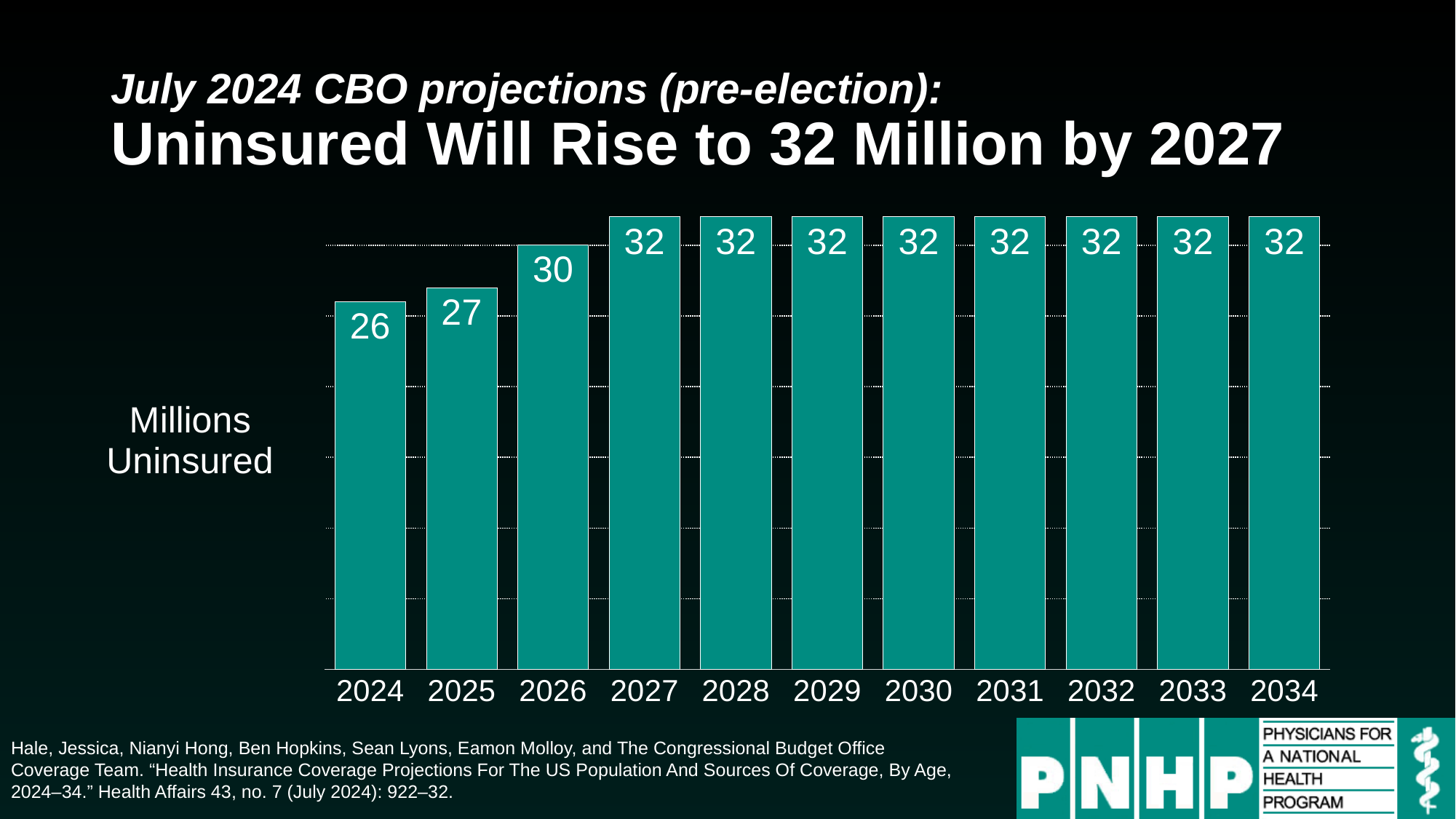
What is the label on the vertical axis? Millions Uninsured What kind of chart is this? bar chart Which is larger, the value for 2025 or the value for 2026? 2026 What is the value for 2026? 30 What is the difference between the values for 2026 and 2025? 3 How many years are shown on the x axis? 11 What is the value for 2030? 32 What is the value for 2024? 26 What is the difference between the values for 2027 and 2024? 6 Do the values rise or fall from 2024 to 2027? rise What is the value for 2025? 27 Which year has the lowest value? 2024